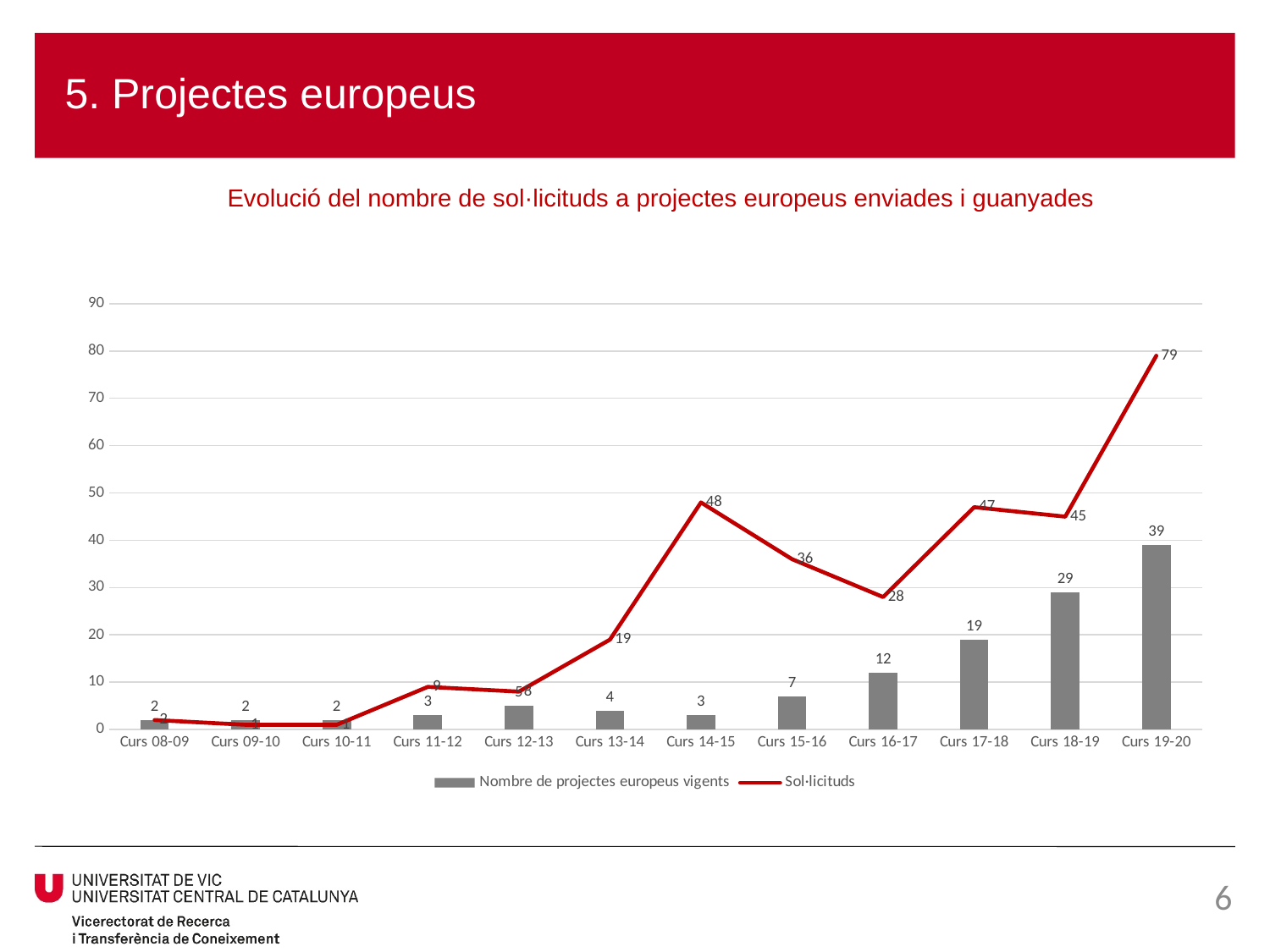
How many course years are shown on the x axis? 12 What is the value of Sol·licituds for Curs 14-15? 48 How many series does the legend list? 2 Is the value of Sol·licituds for Curs 15-16 greater or less than 30? greater What is the value of Nombre de projectes europeus vigents for Curs 19-20? 39 What is the value of Sol·licituds for Curs 19-20? 79 What is the value of Nombre de projectes europeus vigents for Curs 16-17? 12 What is the difference between Sol·licituds and Nombre de projectes europeus vigents for Curs 19-20? 40 What kind of chart is shown on the slide? A combined bar and line chart Which course year has the highest value of Nombre de projectes europeus vigents? Curs 19-20 Which course year has the highest value of Sol·licituds? Curs 19-20 Which is larger: Sol·licituds for Curs 14-15 or for Curs 15-16? Curs 14-15